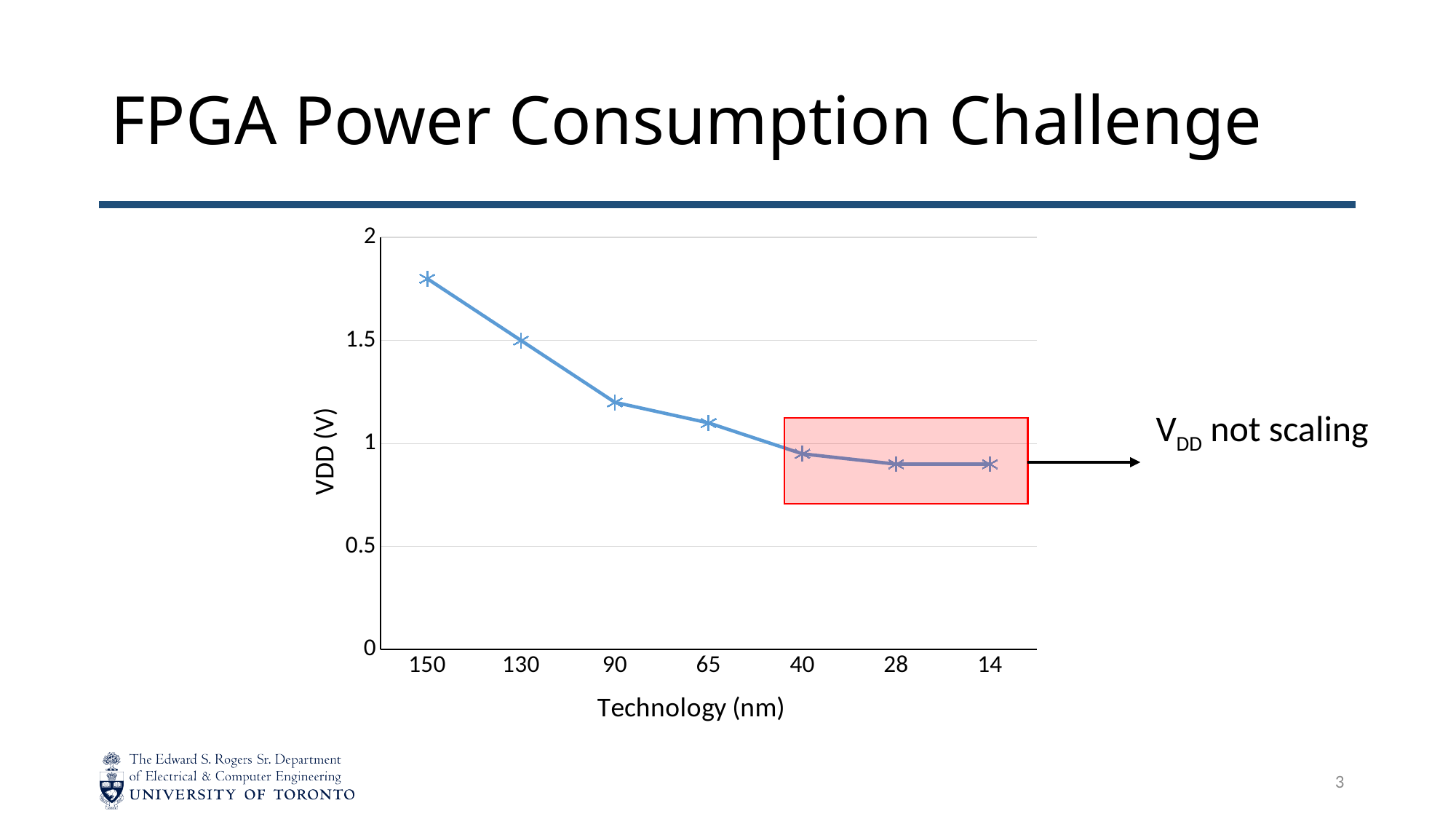
Is the VDD value for 65 nm greater or less than 1? greater What is the label of the x axis? Technology (nm) What is the label of the y axis? VDD (V) Which has a larger VDD, 150 nm or 65 nm? 150 nm How many technology nodes are plotted on the x axis? 7 Is the VDD value for 90 nm greater or less than 1? greater Is the VDD value for 40 nm greater or less than 1? less What kind of chart is shown on the slide? line chart Which technology node has the highest VDD? 150 Do the VDD values rise or fall as you move from 150 nm to 14 nm along the x axis? fall